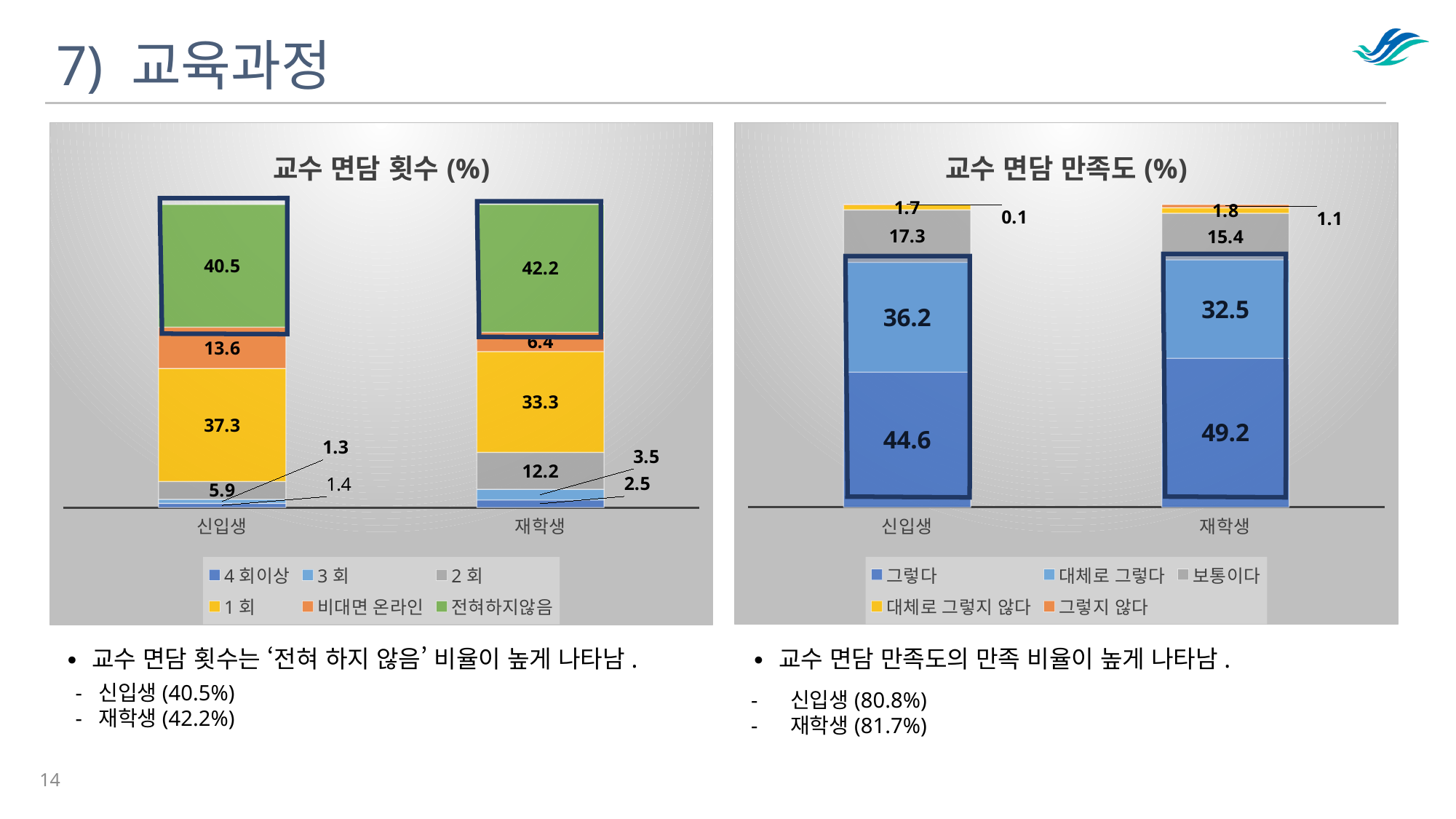
In the '교수 면담 횟수 (%)' chart, what is the difference between the '전혀하지않음' values for 재학생 and 신입생? 1.7 In the '교수 면담 횟수 (%)' chart, what is the value of '1 회' for 재학생? 33.3 In the '교수 면담 횟수 (%)' chart, what is the value of '전혀하지않음' for 신입생? 40.5 In the '교수 면담 만족도 (%)' chart, what is the value of '보통이다' for 신입생? 17.3 How many series does the legend of the '교수 면담 횟수 (%)' chart list? 6 In the '교수 면담 만족도 (%)' chart, what is the value of '그렇지 않다' for 재학생? 1.1 In the '교수 면담 만족도 (%)' chart, which group has the larger '대체로 그렇다' value, 신입생 or 재학생? 신입생 In the '교수 면담 만족도 (%)' chart, what is the difference between the '그렇다' values for 재학생 and 신입생? 4.6 In the '교수 면담 횟수 (%)' chart, which group has the larger '2 회' value, 신입생 or 재학생? 재학생 What type of chart is the '교수 면담 만족도 (%)' chart? Stacked bar chart In the '교수 면담 횟수 (%)' chart, what is the value of '비대면 온라인' for 신입생? 13.6 In the '교수 면담 만족도 (%)' chart, what is the value of '그렇다' for 재학생? 49.2